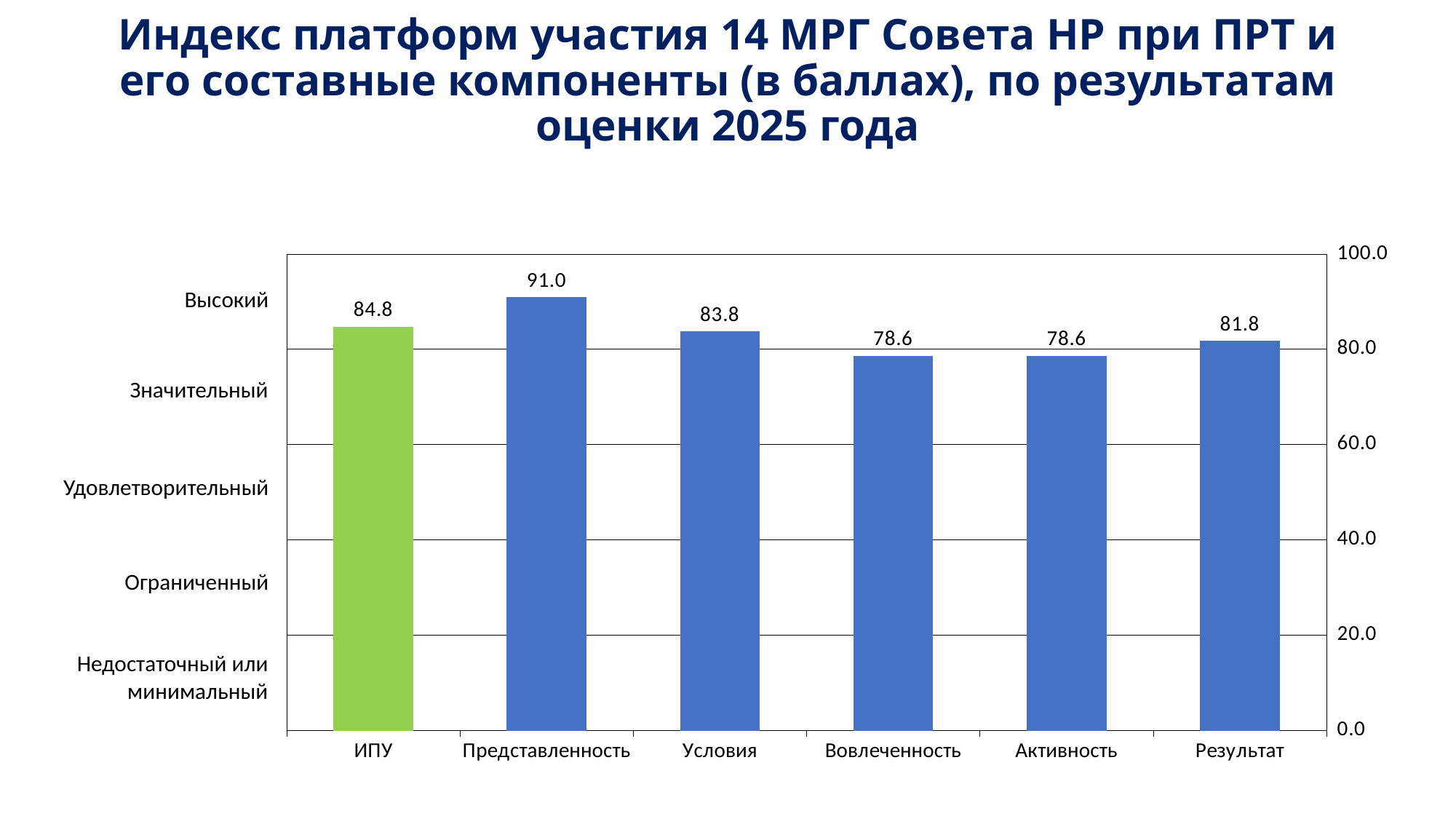
How many categories are shown on the x axis? 6 What is the value for ИПУ? 84.8 What is the value for Представленность? 91.0 What is the value for Результат? 81.8 Is the value for Активность greater or less than 80.0? less Which is larger, the value for Условия or the value for Результат? Условия What is the difference between the values for Условия and Вовлеченность? 5.2 What is the value for Условия? 83.8 Which bar is coloured green rather than blue? ИПУ Which category has the highest value? Представленность What kind of chart is shown on the slide? bar chart What is the difference between the values for Представленность and ИПУ? 6.2